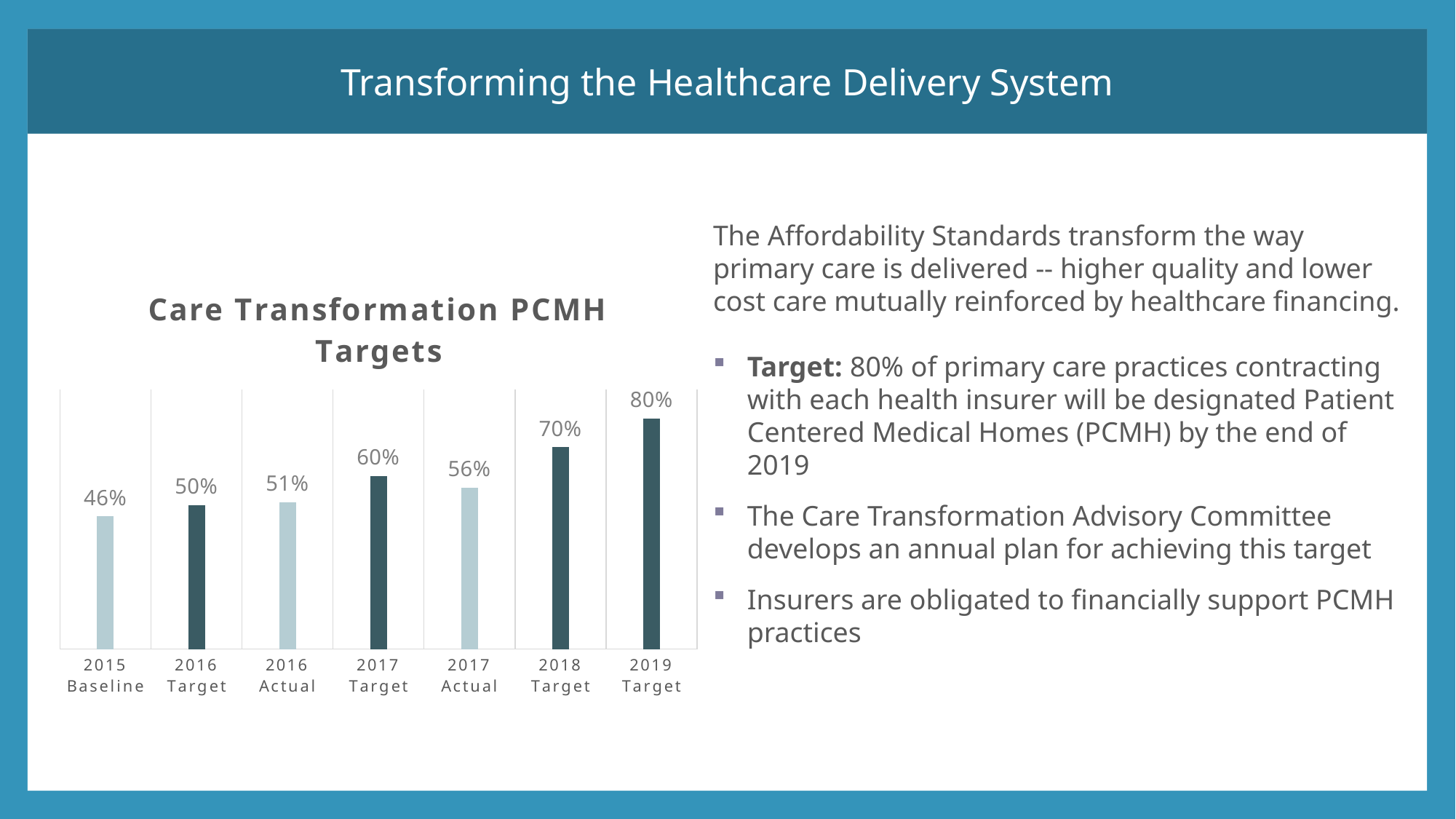
What is the value for 2017 Actual? 56% Which category has the highest value? 2019 Target What is the value for 2015 Baseline? 46% How many bars are shown in the chart? 7 What is the difference between the 2017 Target and the 2017 Actual? 4% What is the difference between the 2019 Target and the 2015 Baseline? 34% Which is larger, 2016 Actual or 2016 Target? 2016 Actual What is the title of the chart? Care Transformation PCMH Targets Which category has the lowest value? 2015 Baseline What is the value for 2018 Target? 70% Do the target values rise or fall from 2016 Target to 2019 Target? Rise What kind of chart is shown? Bar chart